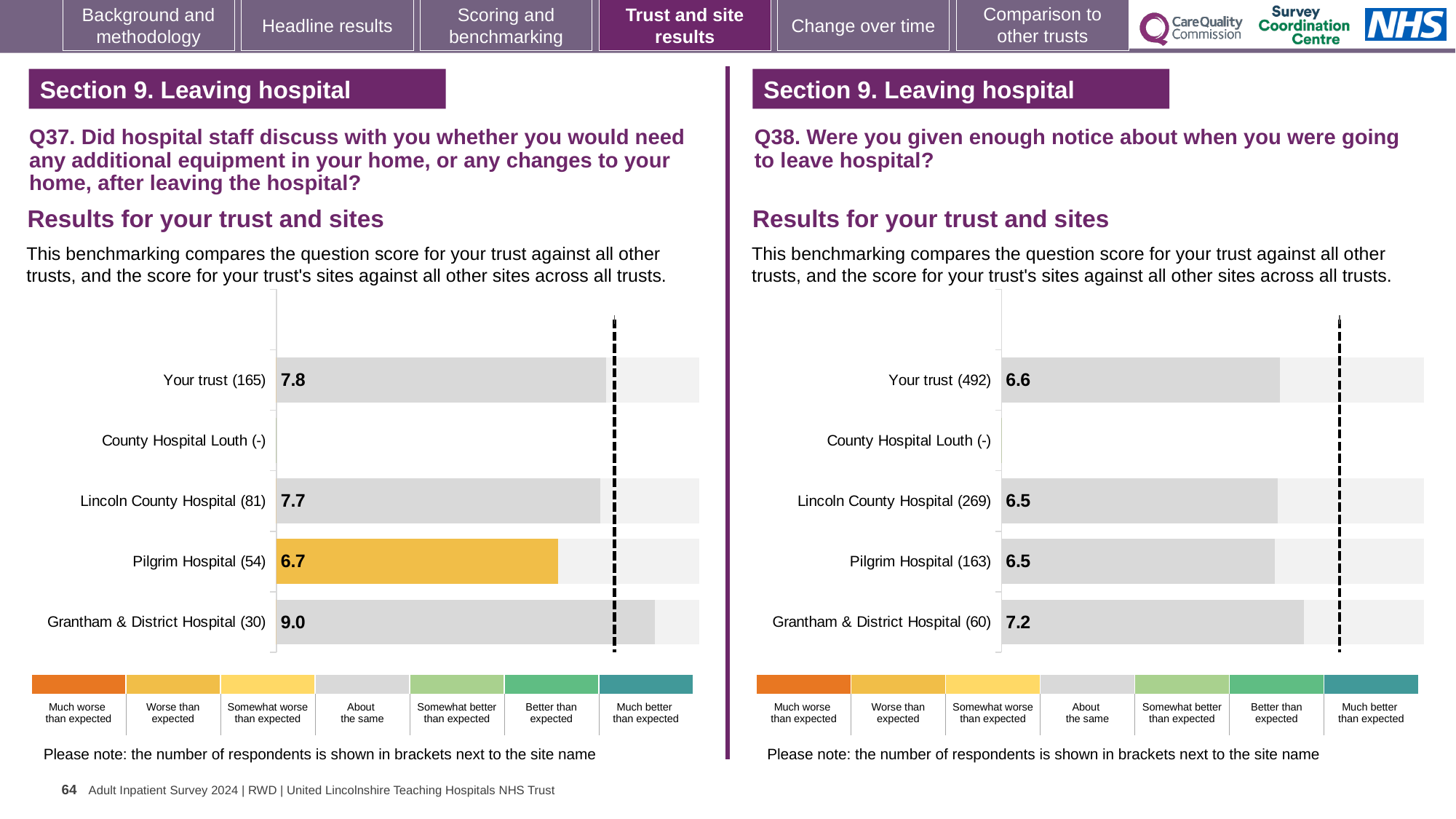
In the Q38 chart, what is the score for Grantham & District Hospital? 7.2 In the Q38 chart, which is larger, the score for Your trust or the score for Lincoln County Hospital? Your trust In the Q38 chart, which site has the highest score? Grantham & District Hospital In the Q37 chart, what is the difference between the scores for Grantham & District Hospital and Pilgrim Hospital? 2.3 What kind of chart is used for the Q38 results? Bar chart In the Q38 chart, how many respondents are shown for Your trust? 492 In the Q37 chart, which site has the highest score? Grantham & District Hospital In the Q37 chart, what is the score for Your trust? 7.8 In the Q37 chart, which site has the lowest score? Pilgrim Hospital In the Q38 chart, what is the score for Your trust? 6.6 In the Q37 chart, what is the score for Pilgrim Hospital? 6.7 How many categories are listed on the y axis of the Q37 chart? 5